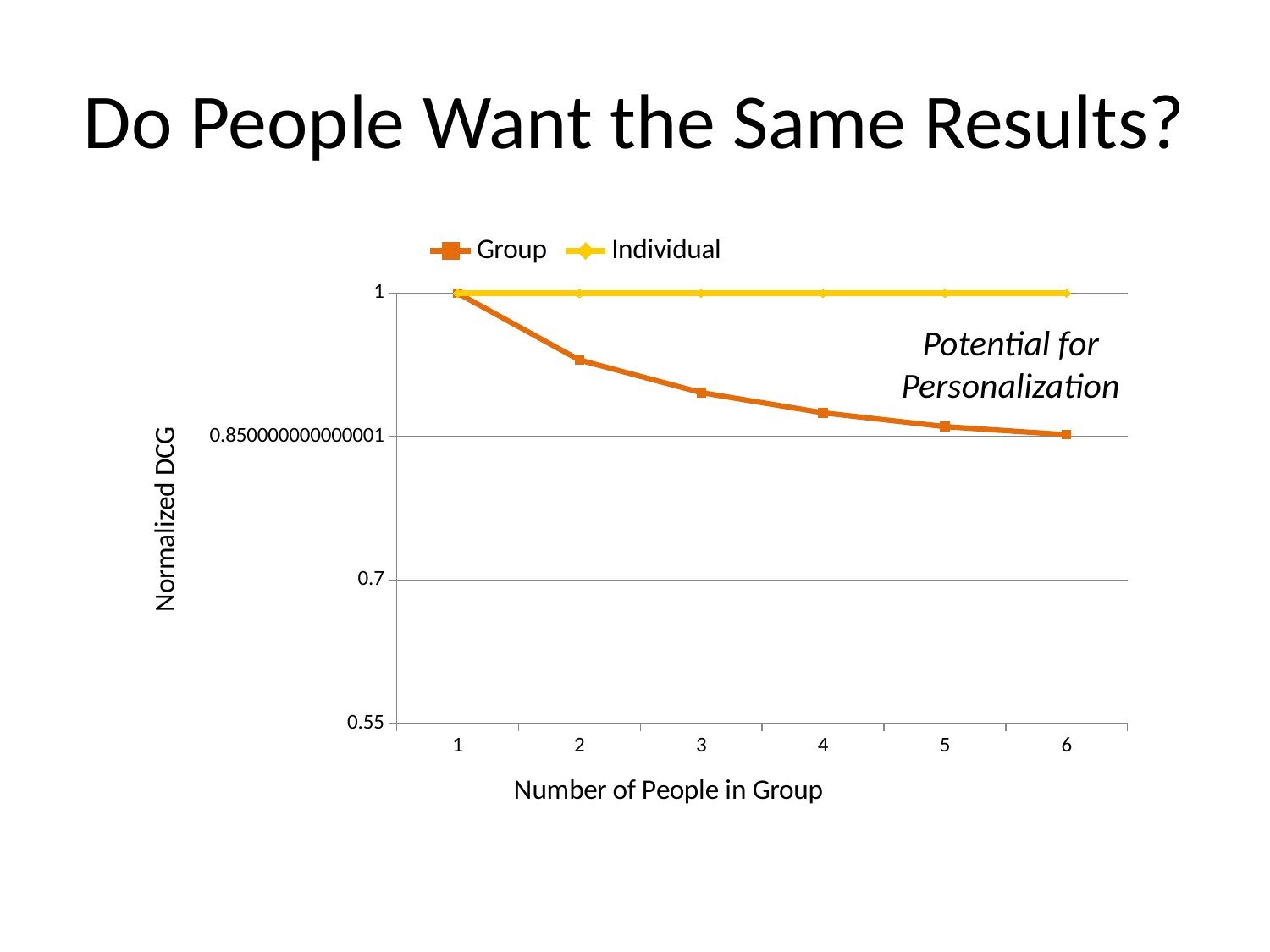
At 4 people in the group, which series has the higher Normalized DCG, Group or Individual? Individual What is the Normalized DCG value for the Group series at 1 person in the group? 1 Is the Group value at 3 people in the group greater or less than 0.7? greater At which number of people in the group is the Group series lowest? 6 Is the Group value at 2 people in the group greater or less than 0.85? greater What is the title of the y axis? Normalized DCG Does the Individual series rise, fall, or stay flat across the x axis? stay flat How many points are plotted along the x axis for each series? 6 What kind of chart is shown on the slide? line chart What is the Normalized DCG value for the Individual series at 3 people in the group? 1 Does the Group series rise or fall as the number of people in the group increases? fall How many series does the legend list? 2